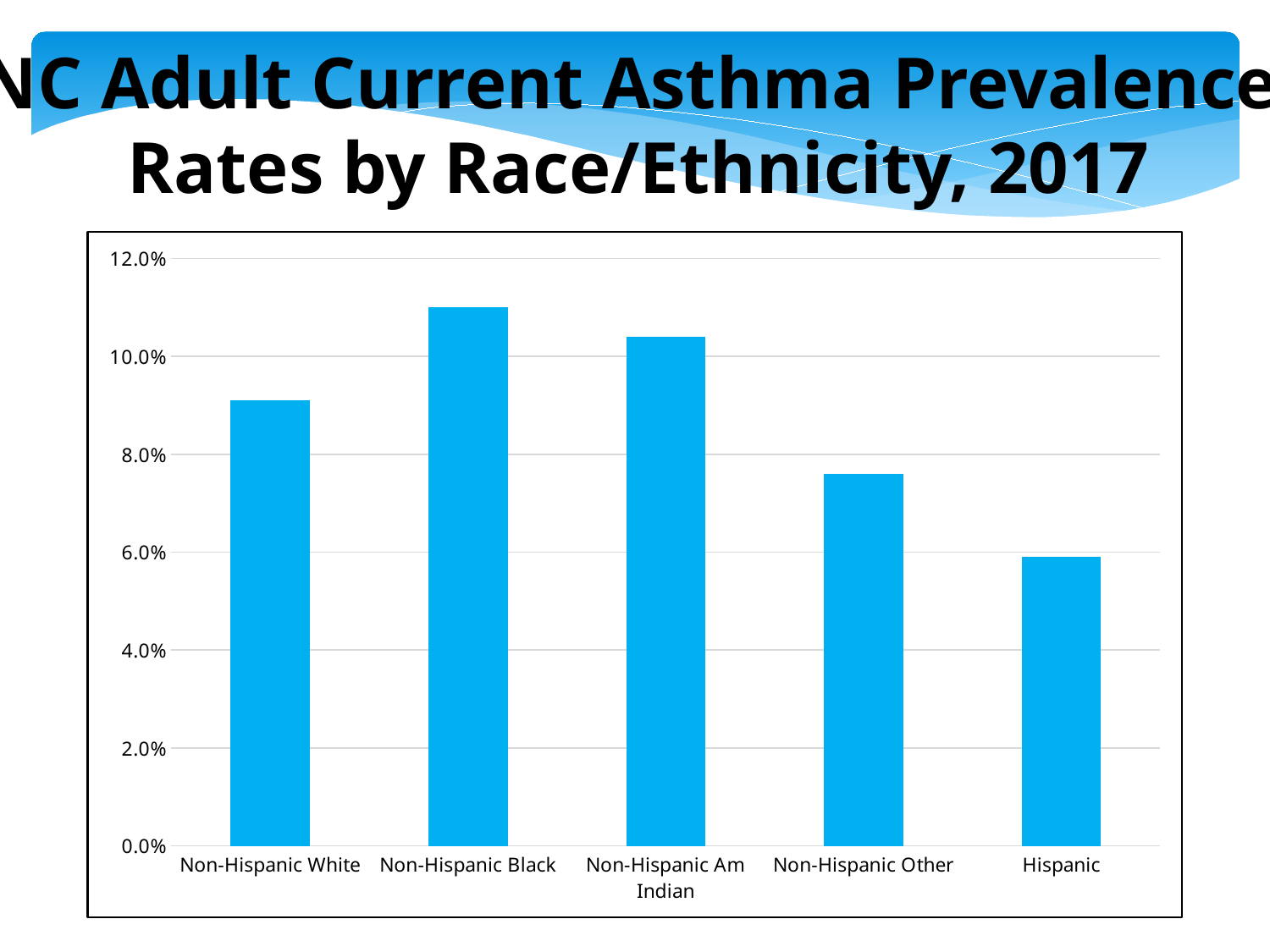
Is the value for Non-Hispanic Black greater or less than 10.0%? greater What kind of chart is shown on the slide? bar chart Is the value for Non-Hispanic White greater or less than 8.0%? greater Which race/ethnicity category has the highest asthma prevalence rate? Non-Hispanic Black Which race/ethnicity category has the lowest asthma prevalence rate? Hispanic What colour are the bars in the chart? blue How many race/ethnicity categories are shown on the x axis? 5 Which has a higher asthma prevalence rate, Non-Hispanic Black or Non-Hispanic Am Indian? Non-Hispanic Black Is the value for Non-Hispanic Other greater or less than 8.0%? less Which has a higher asthma prevalence rate, Non-Hispanic White or Non-Hispanic Other? Non-Hispanic White What year does the chart title say the data is for? 2017